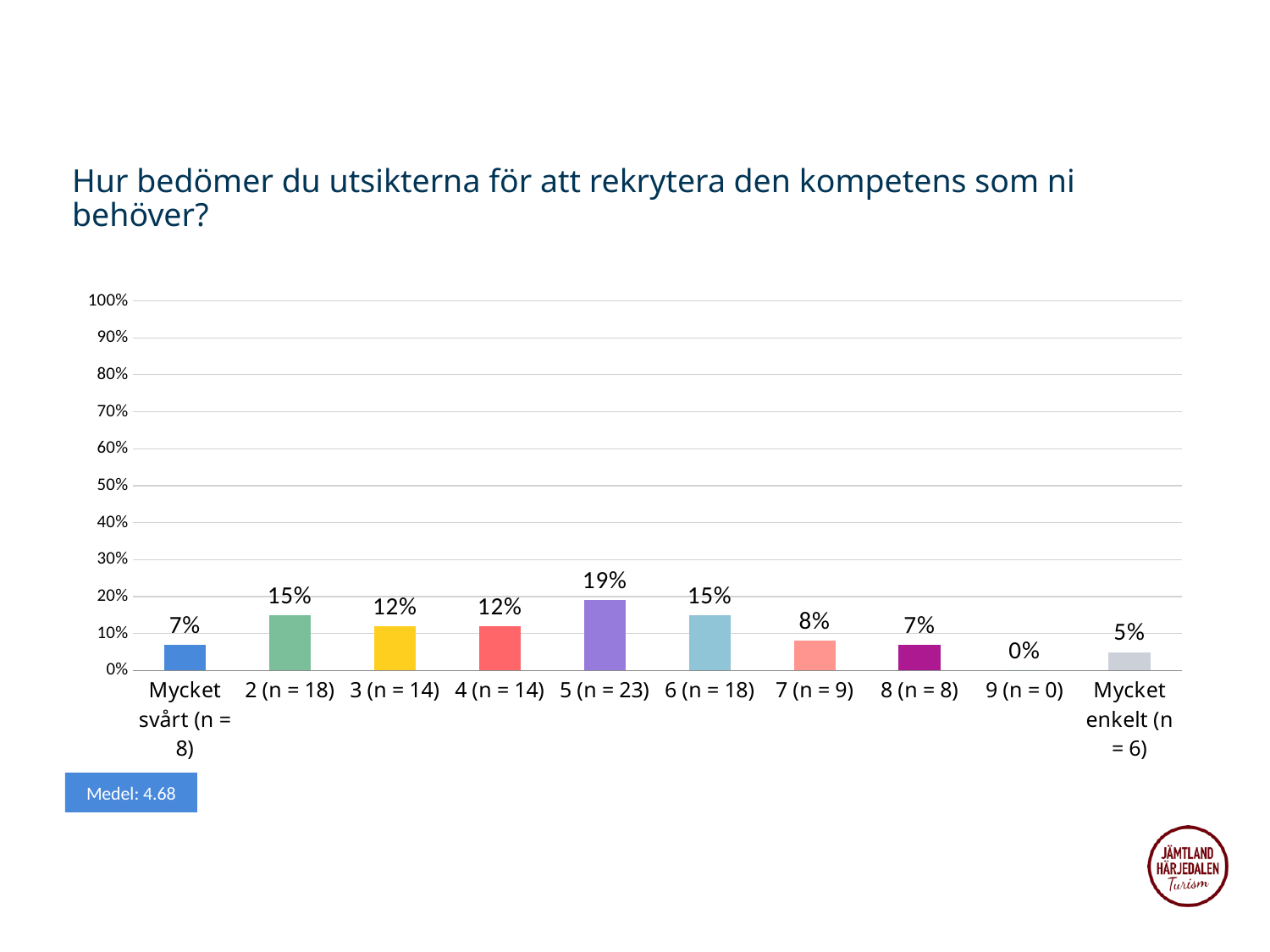
What mean value (Medel) is shown on the slide? 4.68 Which is larger, the value for "7 (n = 9)" or the value for "3 (n = 14)"? 3 (n = 14) Which category has the lowest value? 9 (n = 0) Is the value for "6 (n = 18)" greater or less than 10%? greater What is the difference between the values for "5 (n = 23)" and "2 (n = 18)"? 4% What is the value for the category "Mycket svårt (n = 8)"? 7% What kind of chart is shown on the slide? bar chart What is the value for the category "9 (n = 0)"? 0% How many categories are shown on the x axis? 10 Which category has the highest value? 5 (n = 23) What is the value for the category "5 (n = 23)"? 19% What is the value for the category "Mycket enkelt (n = 6)"? 5%